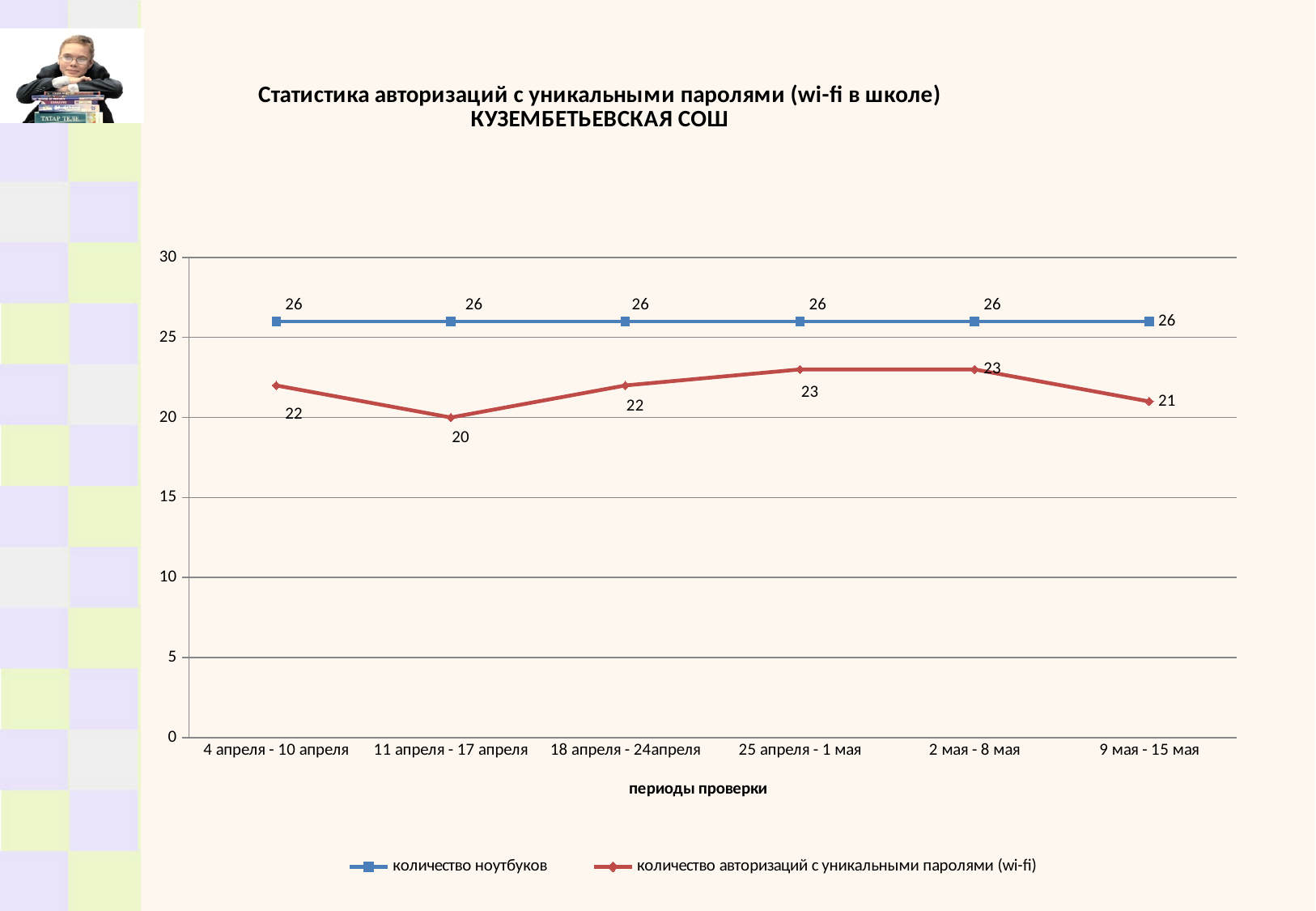
In which period is 'количество авторизаций с уникальными паролями (wi-fi)' lowest? 11 апреля - 17 апреля What is the value of 'количество авторизаций с уникальными паролями (wi-fi)' for the period '11 апреля - 17 апреля'? 20 How many periods are shown on the x axis? 6 Which is larger for the period '4 апреля - 10 апреля': 'количество ноутбуков' or 'количество авторизаций с уникальными паролями (wi-fi)'? количество ноутбуков Does 'количество авторизаций с уникальными паролями (wi-fi)' rise or fall from '2 мая - 8 мая' to '9 мая - 15 мая'? fall How many series does the legend list? 2 What is the label of the x axis? периоды проверки What type of chart is shown on the slide? line chart What is the value of 'количество авторизаций с уникальными паролями (wi-fi)' for the period '9 мая - 15 мая'? 21 What colour is the line for 'количество ноутбуков'? blue What is the difference between 'количество ноутбуков' and 'количество авторизаций с уникальными паролями (wi-fi)' for the period '25 апреля - 1 мая'? 3 What is the value of 'количество ноутбуков' for the period '2 мая - 8 мая'? 26